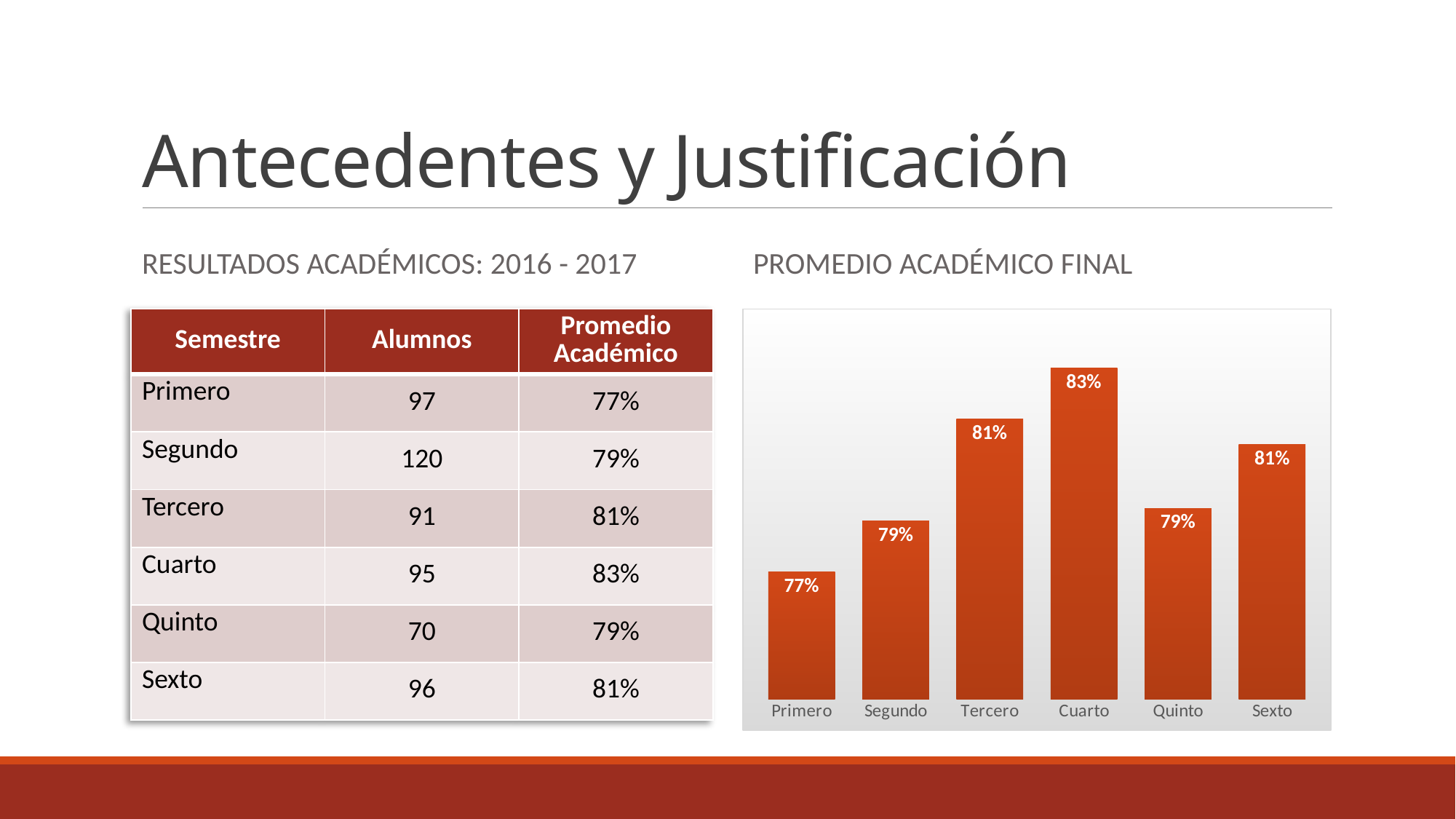
What is the difference between the values for Tercero and Segundo? 2% What is the value for Quinto in the chart? 79% What kind of chart is shown on the slide? Bar chart Do the values rise or fall from Primero to Cuarto? Rise What is the title of the chart? PROMEDIO ACADÉMICO FINAL How many semesters are shown in the chart? 6 Which semester has the highest value in the chart? Cuarto What is the value for Primero in the chart? 77% What is the value for Cuarto in the chart? 83% Which is larger, the value for Tercero or the value for Quinto? Tercero What is the difference between the values for Cuarto and Primero? 6% Which semester has the lowest value in the chart? Primero